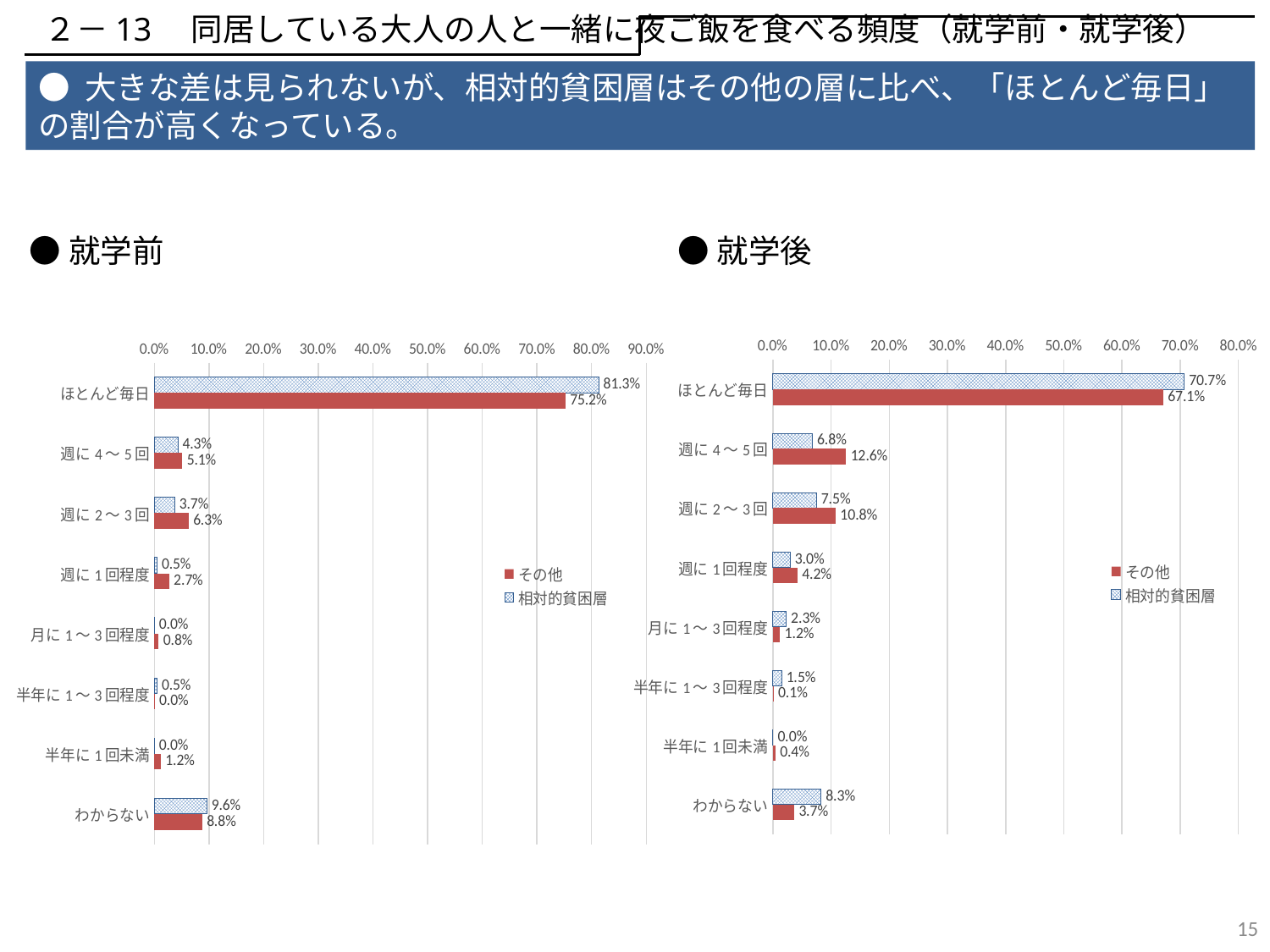
In the 就学前 chart, what is the value for 相対的貧困層 in the ほとんど毎日 category? 81.3% How many categories are shown in the 就学後 chart? 8 In the 就学後 chart, what is the value for その他 in the 週に４〜５回 category? 12.6% In the 就学後 chart, what is the value for 相対的貧困層 in the わからない category? 8.3% In the 就学後 chart, which category has the highest value for その他? ほとんど毎日 In the 就学後 chart, which series has the larger value for 週に４〜５回, その他 or 相対的貧困層? その他 In the 就学前 chart, what is the difference between the 相対的貧困層 and その他 values for ほとんど毎日? 6.1% In the 就学前 chart, is the その他 value for ほとんど毎日 greater or less than 70.0%? greater What type of chart is the 就学後 chart? Bar chart In the 就学後 chart, what is the difference between the その他 and 相対的貧困層 values for 週に２〜３回? 3.3% In the 就学前 chart, what is the value for その他 in the わからない category? 8.8% How many series does the legend of the 就学前 chart list? 2